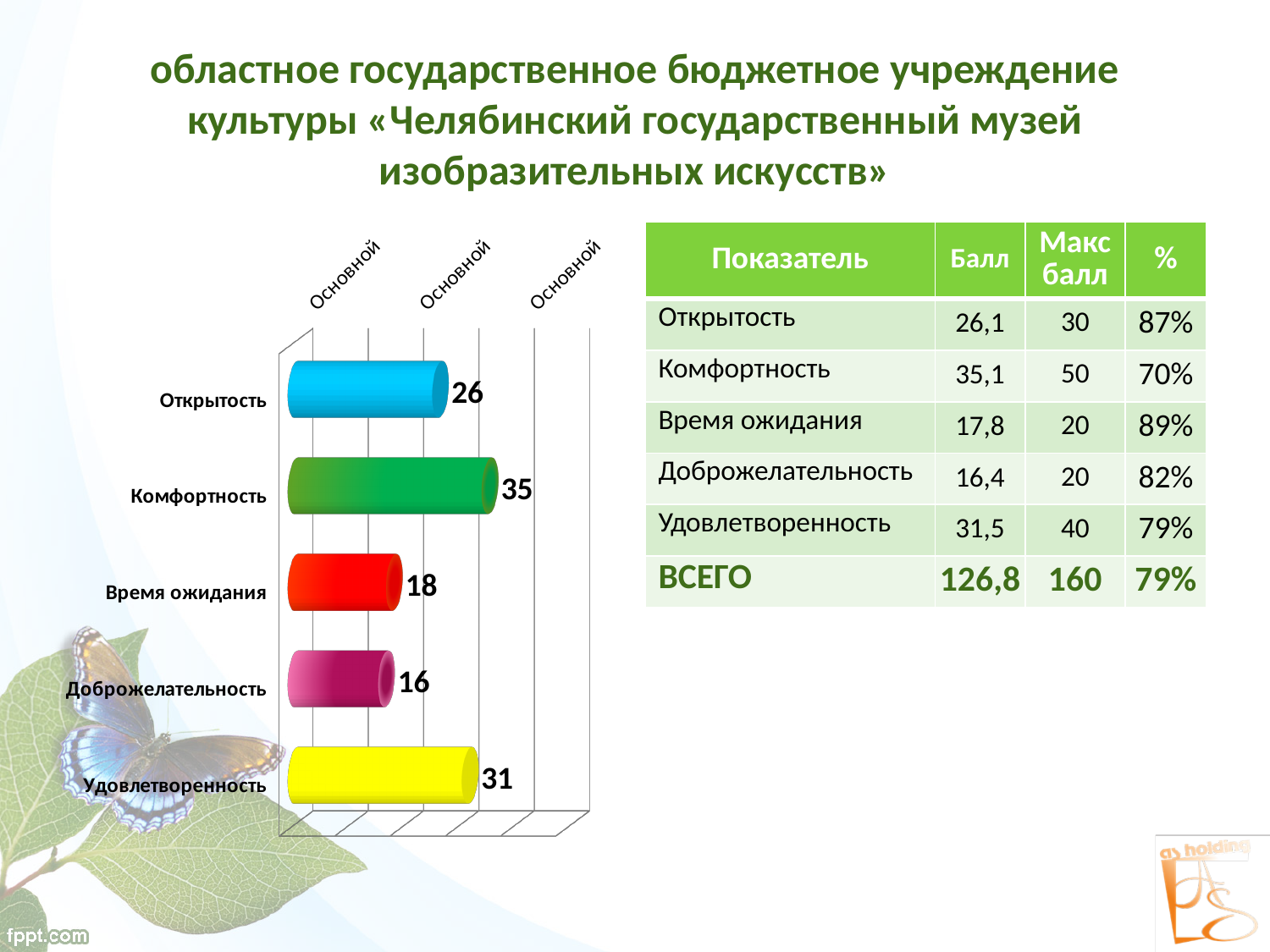
What is the value shown for Открытость in the chart? 26 What type of chart is shown on the slide? bar chart What is the value shown for Удовлетворенность in the chart? 31 Which category has the highest value in the chart? Комфортность What is the difference between the values for Комфортность and Открытость in the chart? 9 Which category has the lowest value in the chart? Доброжелательность Which is larger in the chart, the value for Удовлетворенность or the value for Открытость? Удовлетворенность What is the value shown for Время ожидания in the chart? 18 What is the value shown for Доброжелательность in the chart? 16 What colour is the bar for Время ожидания in the chart? red What is the value shown for Комфортность in the chart? 35 How many categories are shown in the chart? 5